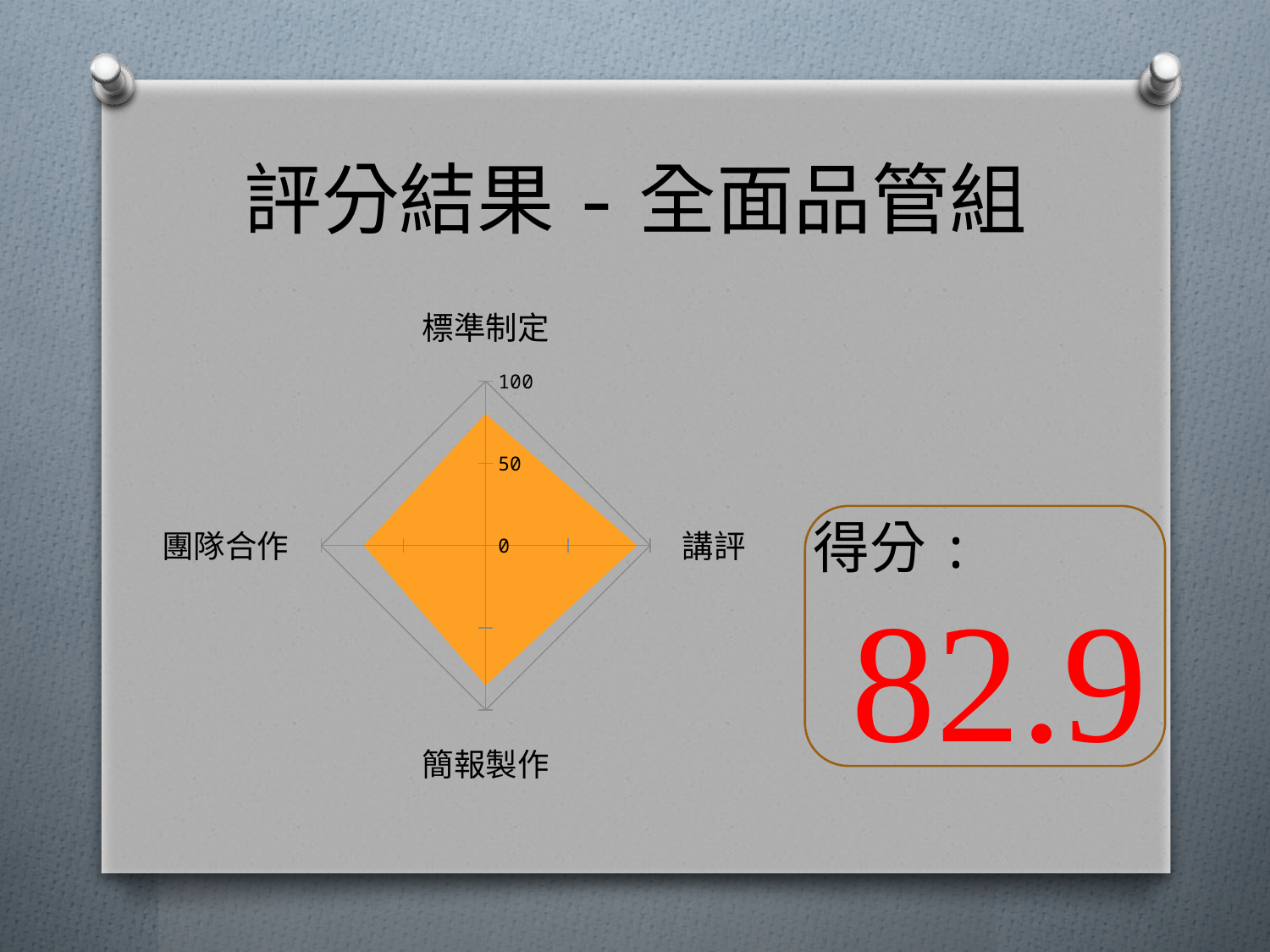
What colour is the filled data area of the radar chart? orange How many categories (axes) does the radar chart have? 4 Is the value for 簡報製作 greater or less than 50? greater What is the maximum value shown on the radar chart's axis scale? 100 What kind of chart is shown on the slide? radar chart Is the value for 標準制定 greater or less than 50? greater Is the value for 講評 greater or less than 50? greater Which category label appears at the top of the radar chart? 標準制定